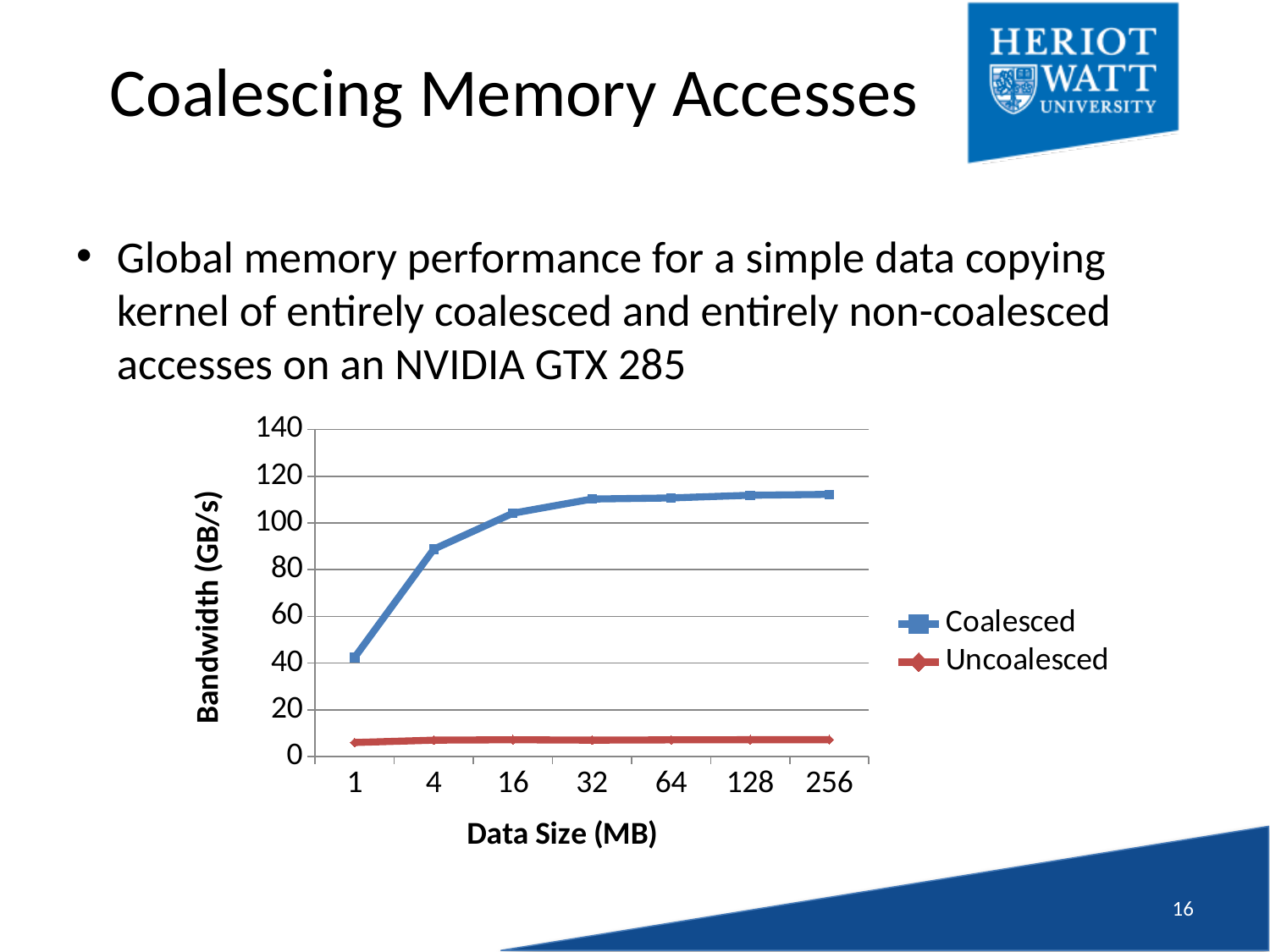
Which series has the higher bandwidth at a data size of 64 MB, Coalesced or Uncoalesced? Coalesced What is the label of the y axis? Bandwidth (GB/s) Is the Coalesced bandwidth at 1 MB greater or less than 60 GB/s? less How many series does the legend list? 2 Is the Uncoalesced bandwidth at 128 MB greater or less than 20 GB/s? less How many data sizes are plotted along the x axis? 7 What kind of chart is shown on the slide? line chart Which series is drawn in red? Uncoalesced Is the Coalesced bandwidth at 256 MB greater or less than 120 GB/s? less Does the Coalesced bandwidth rise or fall as the data size increases from 1 MB to 32 MB? rise At which data size is the Coalesced bandwidth lowest? 1